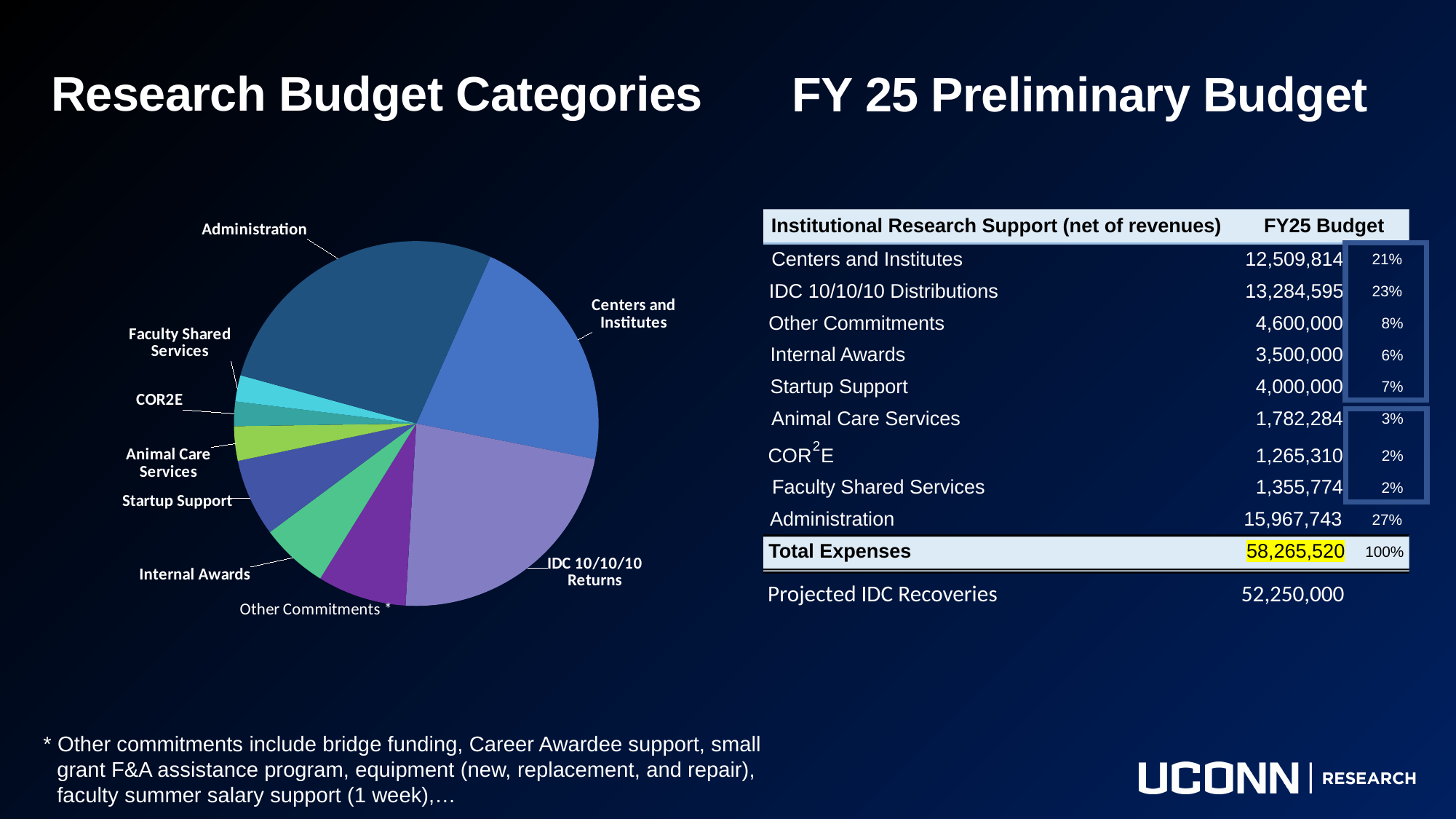
Which category has the largest slice in the pie chart? Administration According to the table on the slide, what is the Total Expenses figure? 58,265,520 What is the title of the chart on the left of the slide? Research Budget Categories What kind of chart is shown on the left of the slide? pie chart According to the table on the slide, what share of Total Expenses is IDC 10/10/10 Distributions? 23% Which pie chart category label carries an asterisk referring to a footnote? Other Commitments In the pie chart, which slice is larger: IDC 10/10/10 Returns or Animal Care Services? IDC 10/10/10 Returns How many categories (slices) does the pie chart have? 9 According to the table on the slide, what is the FY25 Budget for Administration? 15,967,743 According to the table on the slide, what share of Total Expenses is Centers and Institutes? 21% In the pie chart, which slice is larger: Administration or Startup Support? Administration In the pie chart, which slice is larger: Centers and Institutes or Internal Awards? Centers and Institutes